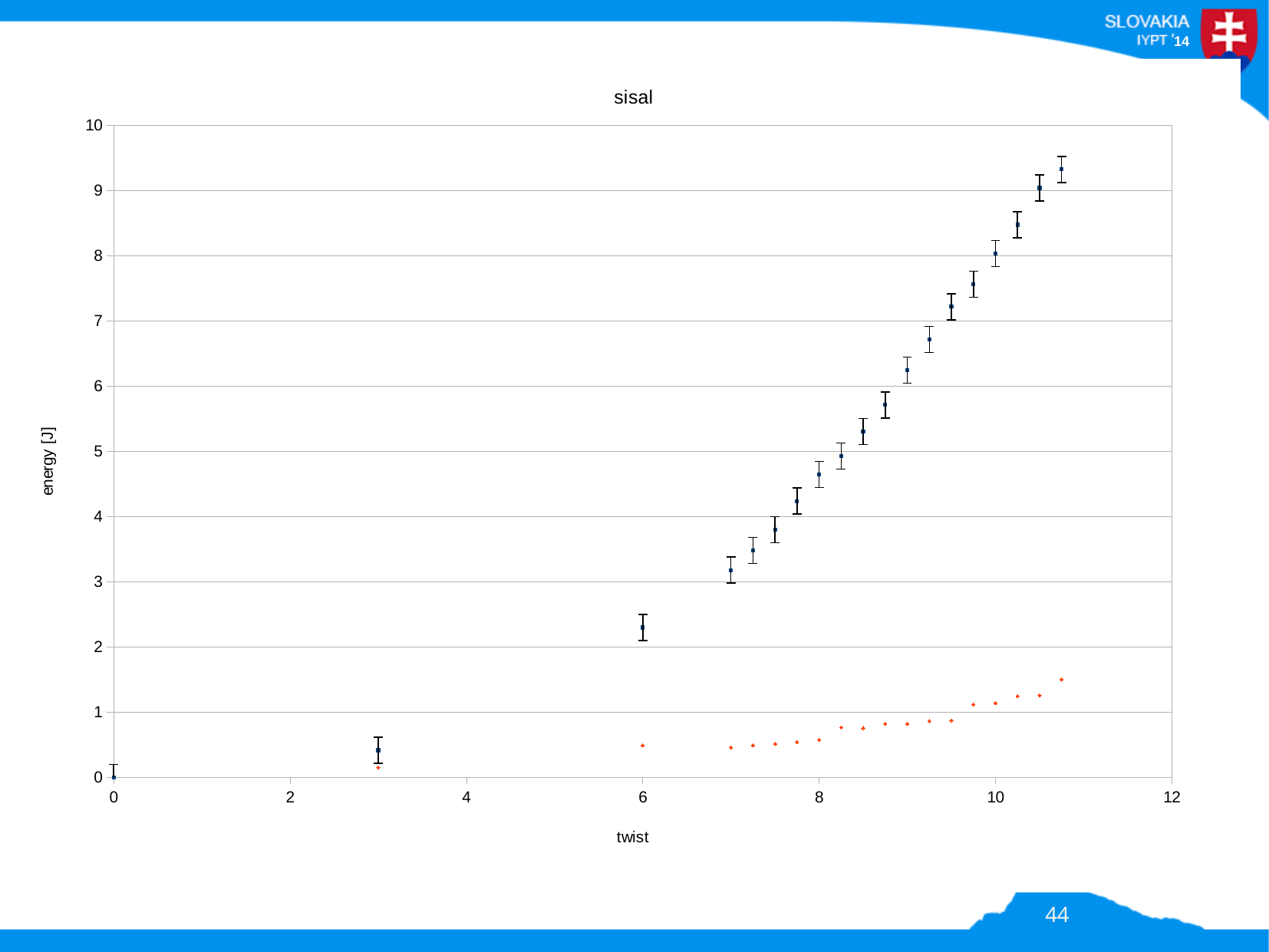
What is the title of the chart? sisal Is the highest energy value of the blue (error-bar) series greater or less than 9? greater Is the energy of the red series at twist 6 greater or less than 1? less Is the highest energy value of the red series greater or less than 2? less At twist 6, which series has the larger energy, the blue (error-bar) series or the red series? blue (error-bar) series What kind of chart is shown on the slide? scatter chart Does the energy of the blue (error-bar) series rise or fall as twist increases? rise What is the label of the y axis? energy [J] Which series reaches the highest energy on the chart? blue (error-bar) series